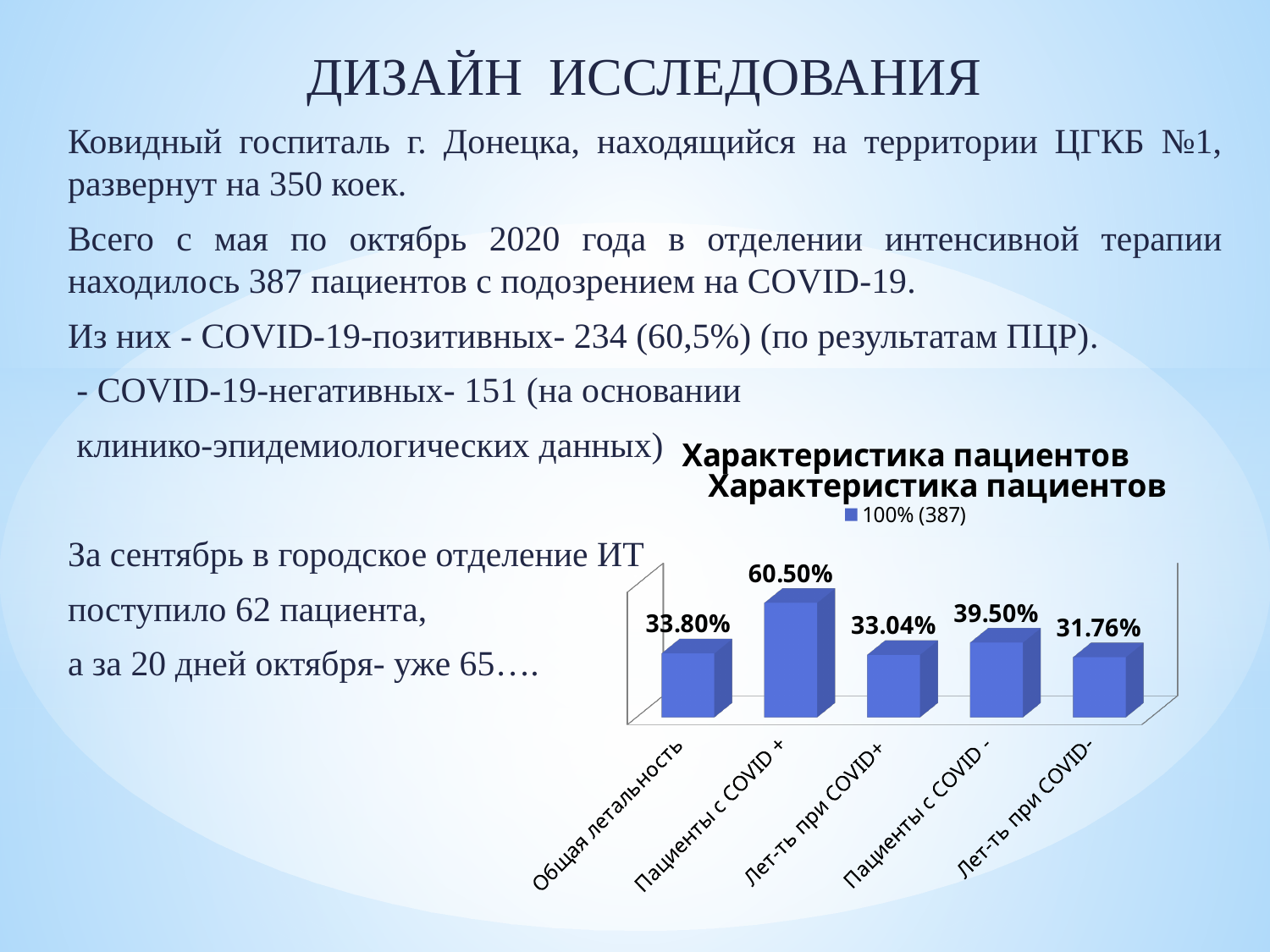
What is the difference between the values for Пациенты с COVID + and Пациенты с COVID -? 21.00% Which category has the highest value? Пациенты с COVID + What is the value for Лет-ть при COVID+? 33.04% What kind of chart is shown on the slide? Bar chart What is the value for Общая летальность? 33.80% What is the legend entry shown for the chart? 100% (387) How many categories are shown in the chart? 5 What is the value for Пациенты с COVID +? 60.50% Which is larger, the value for Общая летальность or the value for Пациенты с COVID -? Пациенты с COVID - Which category has the lowest value? Лет-ть при COVID- What is the value for Лет-ть при COVID-? 31.76% What is the value for Пациенты с COVID -? 39.50%